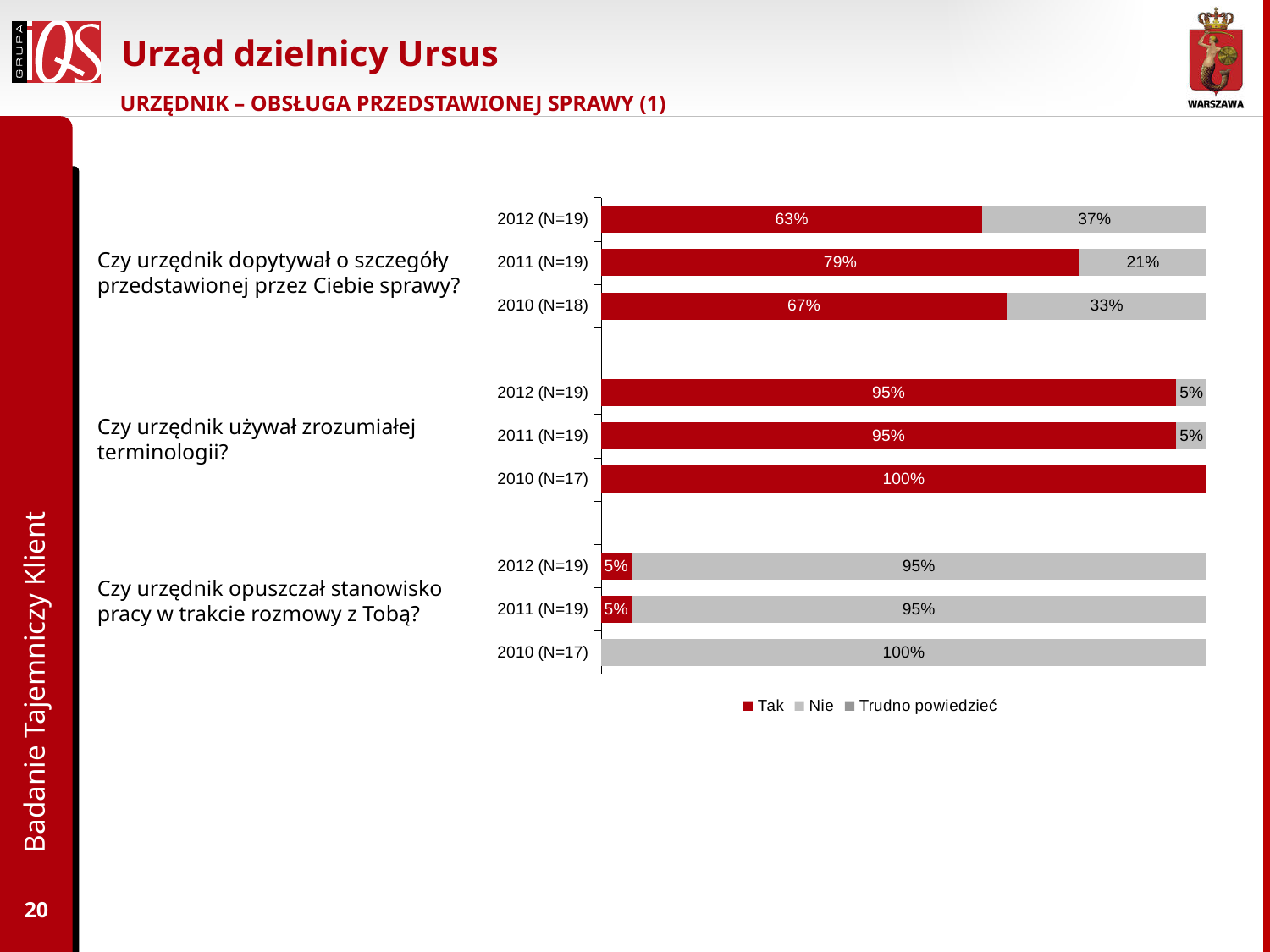
For the question "Czy urzędnik używał zrozumiałej terminologii?", what is the "Nie" value for 2012 (N=19)? 5% For the question "Czy urzędnik dopytywał o szczegóły przedstawionej przez Ciebie sprawy?", what is the "Tak" value for 2012 (N=19)? 63% For the question "Czy urzędnik dopytywał o szczegóły przedstawionej przez Ciebie sprawy?", what is the "Nie" value for 2011 (N=19)? 21% For the question "Czy urzędnik dopytywał o szczegóły przedstawionej przez Ciebie sprawy?", what is the difference between the "Tak" values for 2011 (N=19) and 2012 (N=19)? 16% For the question "Czy urzędnik opuszczał stanowisko pracy w trakcie rozmowy z Tobą?", what is the "Nie" value for 2010 (N=17)? 100% How many series does the legend list? 3 For the question "Czy urzędnik opuszczał stanowisko pracy w trakcie rozmowy z Tobą?", which is larger for 2012 (N=19): the "Tak" value or the "Nie" value? Nie How many bars are plotted on the chart in total? 9 What kind of chart is shown on the slide? stacked bar chart For the question "Czy urzędnik używał zrozumiałej terminologii?", what is the "Tak" value for 2010 (N=17)? 100% What are the legend entries of the chart? Tak, Nie, Trudno powiedzieć For the question "Czy urzędnik dopytywał o szczegóły przedstawionej przez Ciebie sprawy?", which year has the highest "Tak" value? 2011 (N=19)